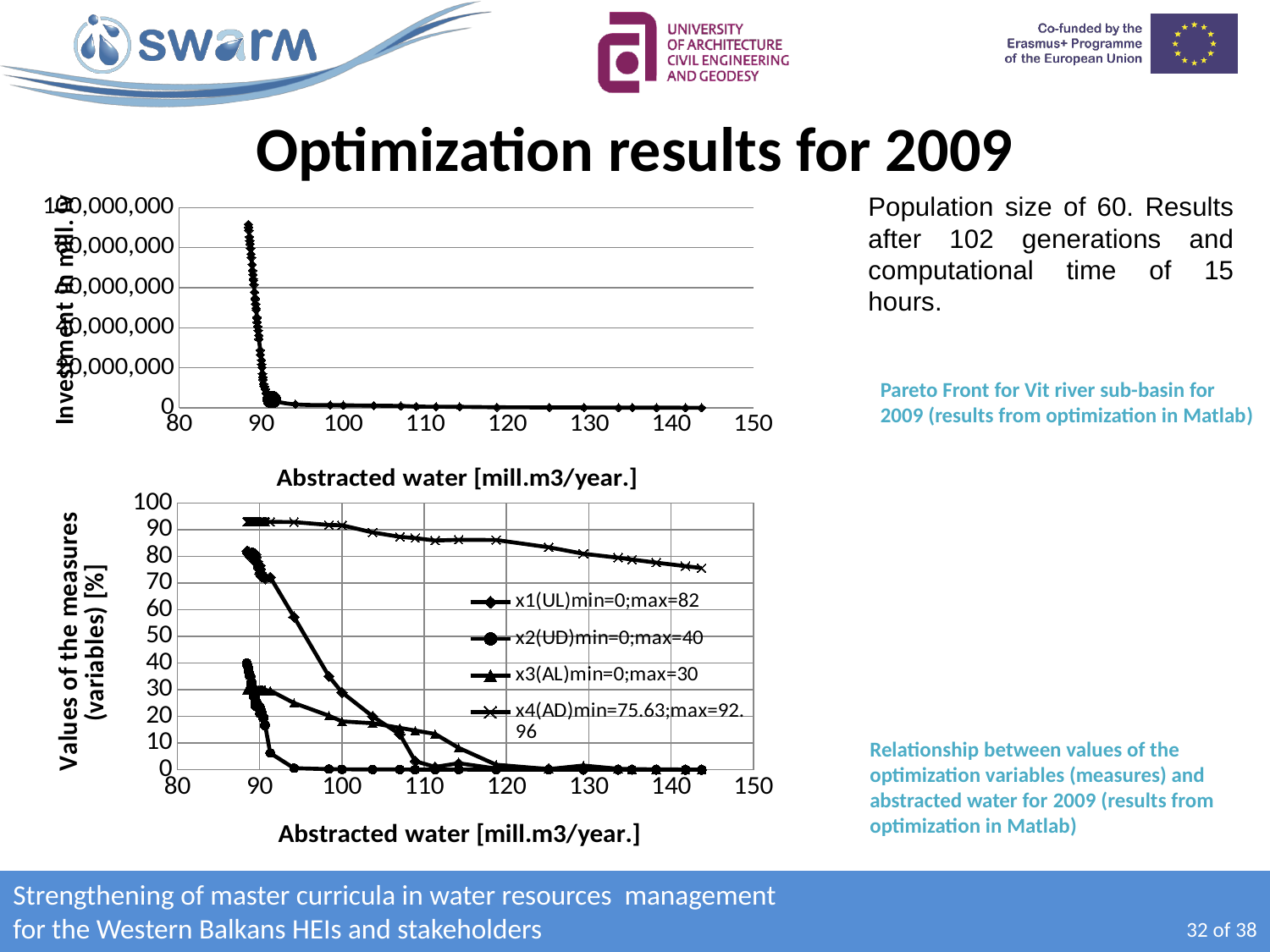
In the bottom chart, is the value of x2(UD) at an abstracted water of 100 greater or less than 10? less In the top chart (Pareto Front for Vit river sub-basin for 2009), does investment rise or fall as abstracted water increases? fall In the top chart (Pareto Front), is the investment at an abstracted water of 100 greater or less than 20,000,000? less In the bottom chart, do the values of the x4(AD) series rise or fall as abstracted water increases? fall In the bottom chart, at an abstracted water of 100, which series has the larger value: x1(UL) or x3(AL)? x1(UL) In the bottom chart, which series has the highest values at an abstracted water of 140? x4(AD)min=75.63;max=92.96 What is the x-axis label of the bottom chart? Abstracted water [mill.m3/year.] How many series does the legend of the bottom chart list? 4 In the bottom chart, at an abstracted water of 90, which series has the larger value: x4(AD) or x1(UL)? x4(AD) In the bottom chart, is the value of x4(AD) at an abstracted water of 120 greater or less than 90? less According to the legend of the bottom chart, what is the maximum value of x4(AD)? 92.96 What kind of chart is the bottom chart (Relationship between values of the optimization variables and abstracted water)? line chart